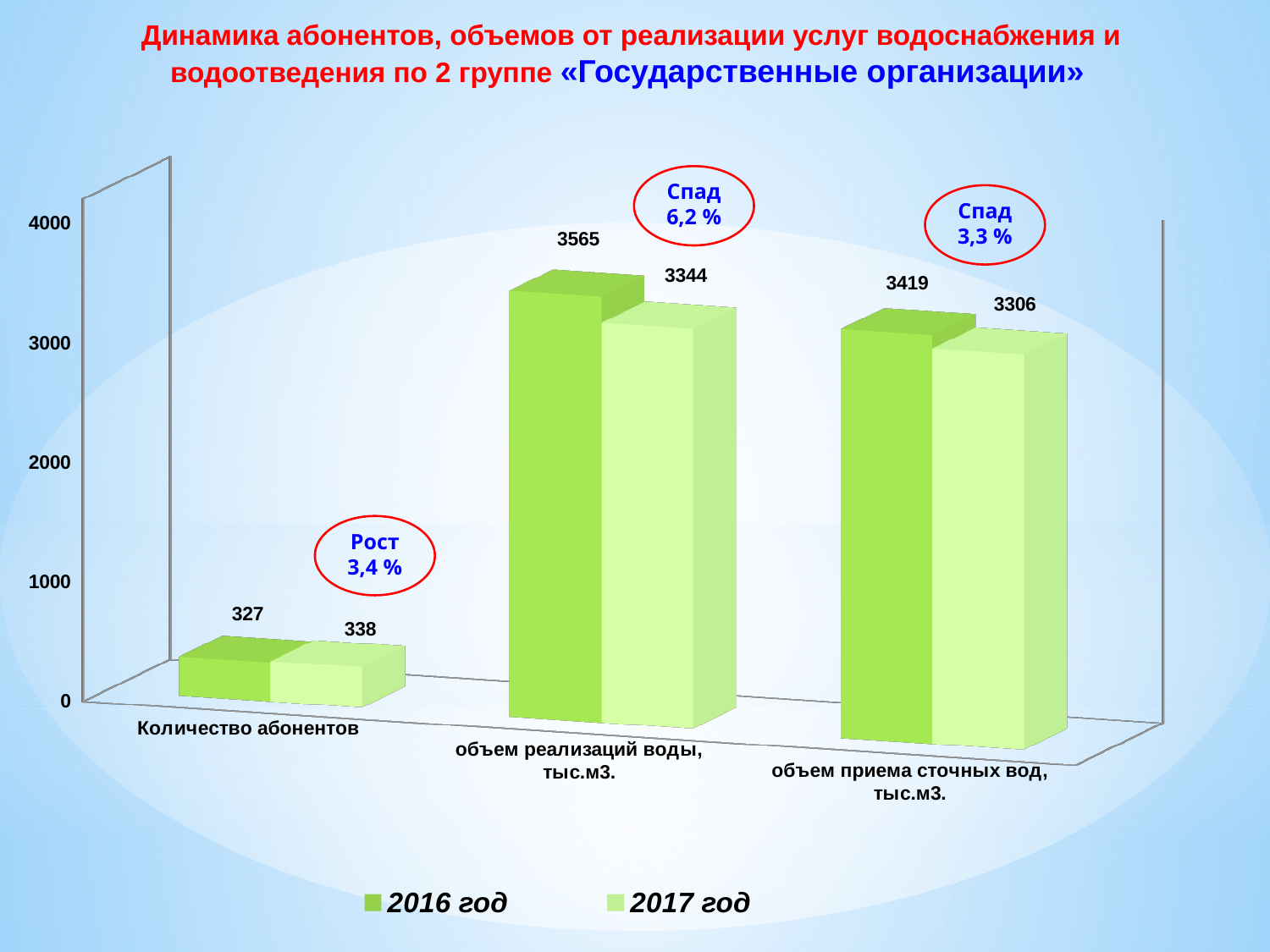
Which is larger for 'объем приема сточных вод, тыс.м3.': the 2016 год value or the 2017 год value? 2016 год What is the value for 'объем приема сточных вод, тыс.м3.' in 2017 год? 3306 What is the value for 'объем реализаций воды, тыс.м3.' in 2016 год? 3565 Which category has the highest value in 2016 год? объем реализаций воды, тыс.м3. How many categories are shown on the x axis? 3 What is the value for 'Количество абонентов' in 2016 год? 327 What is the value for 'объем реализаций воды, тыс.м3.' in 2017 год? 3344 What is the value for 'Количество абонентов' in 2017 год? 338 What is the difference between the 2016 год and 2017 год values for 'объем реализаций воды, тыс.м3.'? 221 Which category has the lowest value in 2017 год? Количество абонентов What kind of chart is shown on the slide? bar chart How many series does the legend list? 2